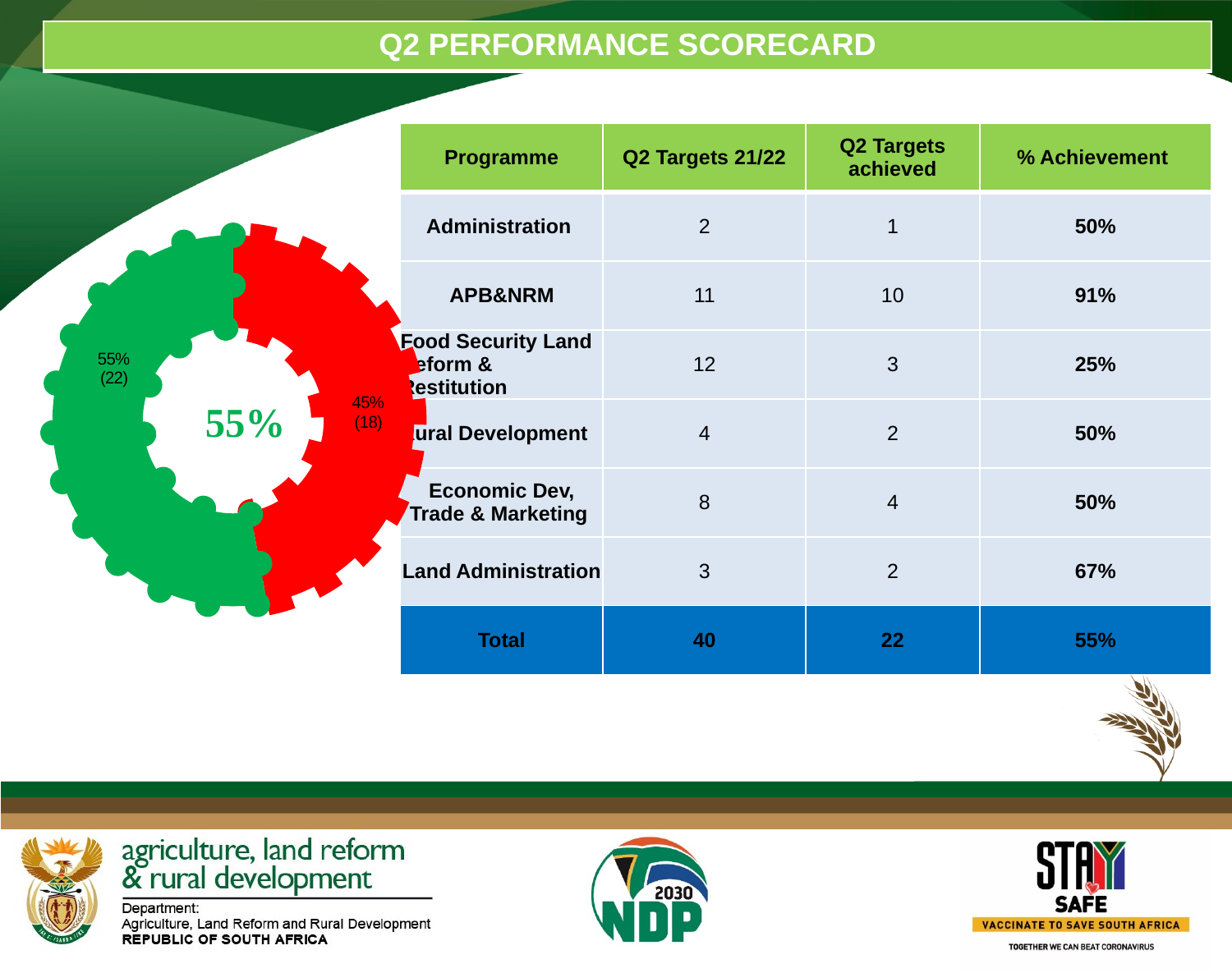
What percentage is shown for the green slice of the donut chart? 55% What is the difference in percentage points between the green and red slices of the donut chart? 10 What is the total of the bracketed counts for the two slices of the donut chart? 40 What colour is the slice representing 45% (18) in the donut chart? Red What kind of chart is shown on the left of the slide? Donut (pie) chart Which slice of the donut chart is the smallest? Red (45%) Which slice of the donut chart is larger, the green one or the red one? Green What value is printed in the centre of the donut chart? 55% What count is shown in brackets for the green slice of the donut chart? 22 What percentage is shown for the red slice of the donut chart? 45% What count is shown in brackets for the red slice of the donut chart? 18 How many slices does the donut chart have? 2